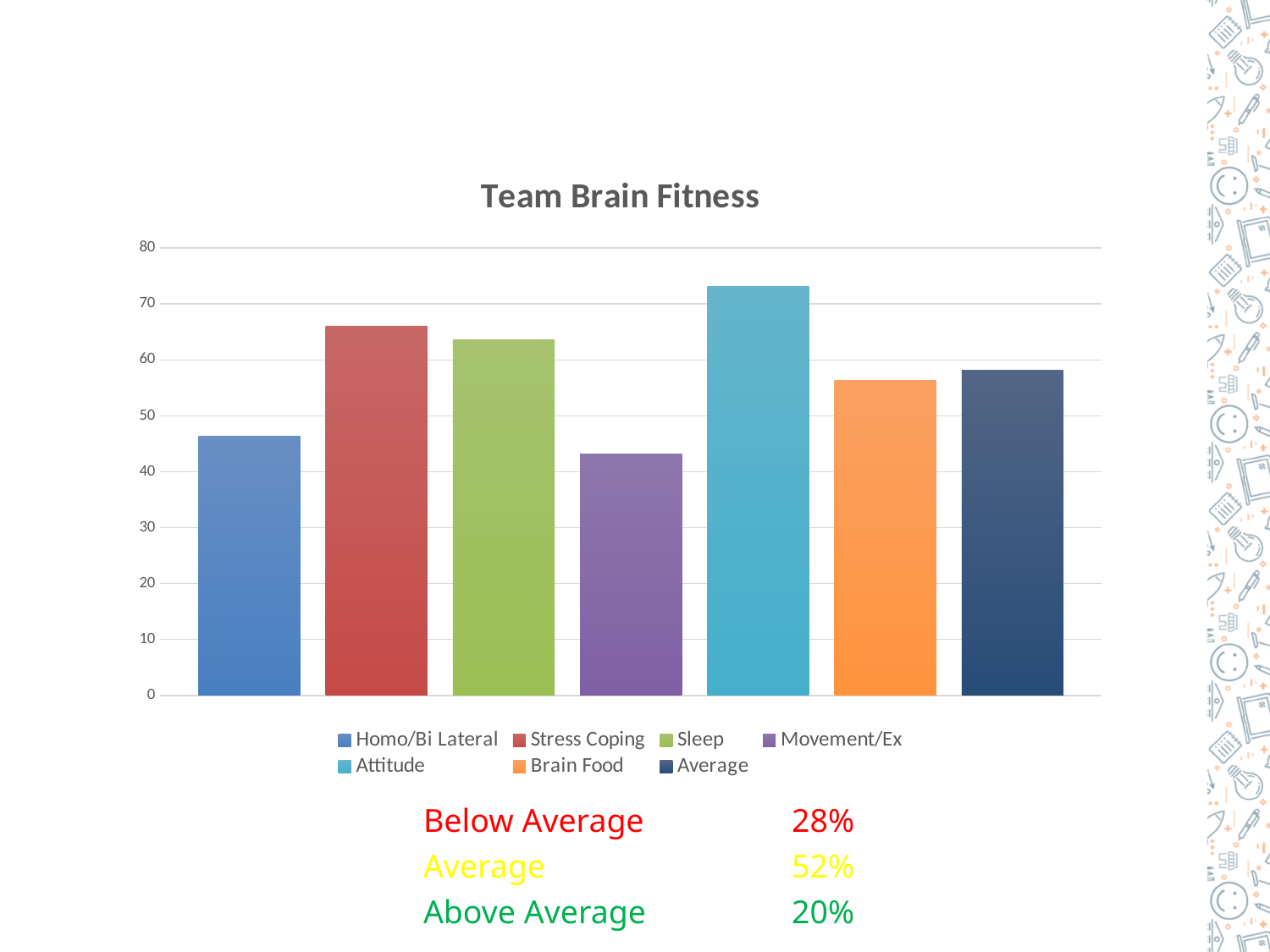
Is the value for Attitude greater or less than 70? greater Is the value for Stress Coping greater or less than 60? greater Is the value for Homo/Bi Lateral greater or less than 50? less How many entries does the chart's legend list? 7 Which legend entry has the tallest bar? Attitude What kind of chart is shown on the slide? bar chart Which is larger, the bar for Homo/Bi Lateral or the bar for Stress Coping? Stress Coping Which is larger, the bar for Attitude or the bar for Brain Food? Attitude Which legend entry has the shortest bar? Movement/Ex How many bars are plotted in the chart? 7 What is the title of the chart? Team Brain Fitness